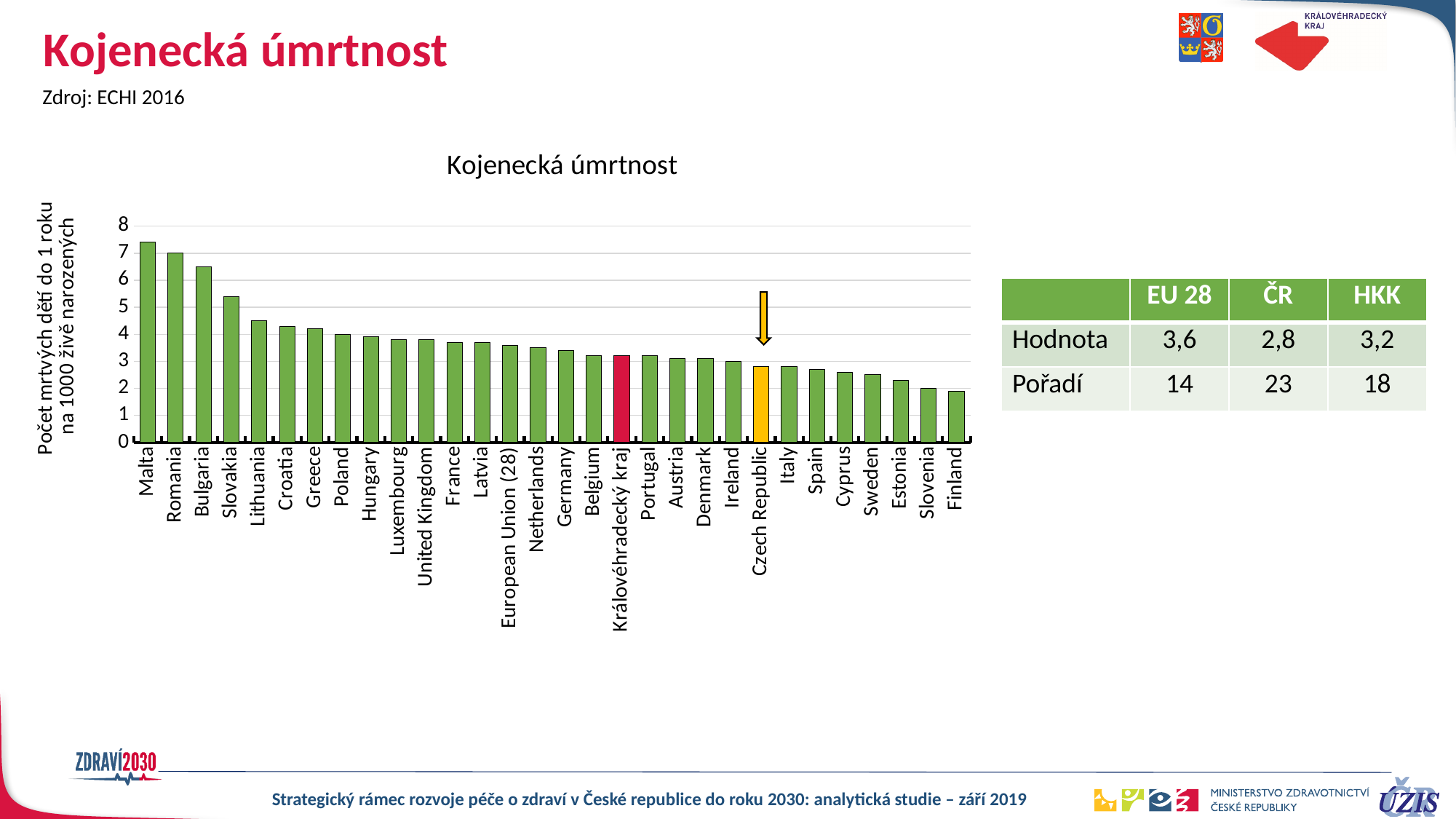
How many categories (bars) are plotted in the chart? 30 Which country has the highest infant mortality in the chart? Malta Which is larger, the value for Romania or the value for Bulgaria? Romania What is the title of the chart? Kojenecká úmrtnost Do the values rise or fall from left to right along the x axis? fall According to the table, what is the value (Hodnota) for Czech Republic (ČR)? 2,8 Which country has the lowest infant mortality in the chart? Finland Is the value for Malta greater or less than 7? greater What type of chart is shown on the slide? bar chart Is the value for Slovakia greater or less than 5? greater